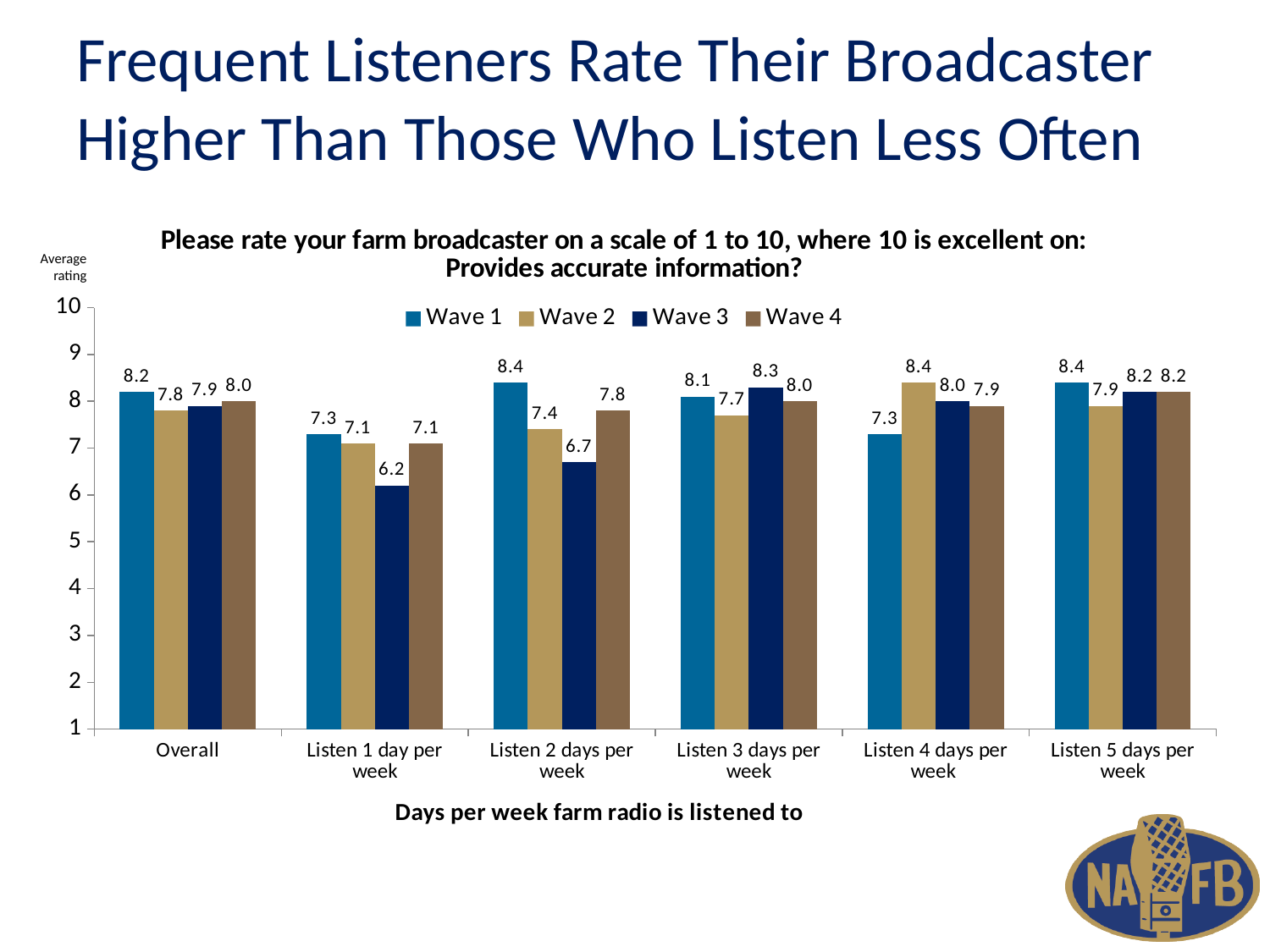
Which is larger for Listen 3 days per week: the Wave 1 rating or the Wave 3 rating? Wave 3 What is the Wave 4 rating for Listen 2 days per week? 7.8 What kind of chart is shown on the slide? Bar chart What is the Wave 3 rating for Listen 1 day per week? 6.2 What is the Wave 1 rating for Overall? 8.2 What is the x-axis label of the chart? Days per week farm radio is listened to Which category has the highest Wave 2 rating? Listen 4 days per week What is the Wave 2 rating for Listen 4 days per week? 8.4 How many series does the legend list? 4 What is the difference between the Wave 1 and Wave 3 ratings for Listen 2 days per week? 1.7 How many categories are shown on the x axis? 6 Which category has the lowest Wave 3 rating? Listen 1 day per week